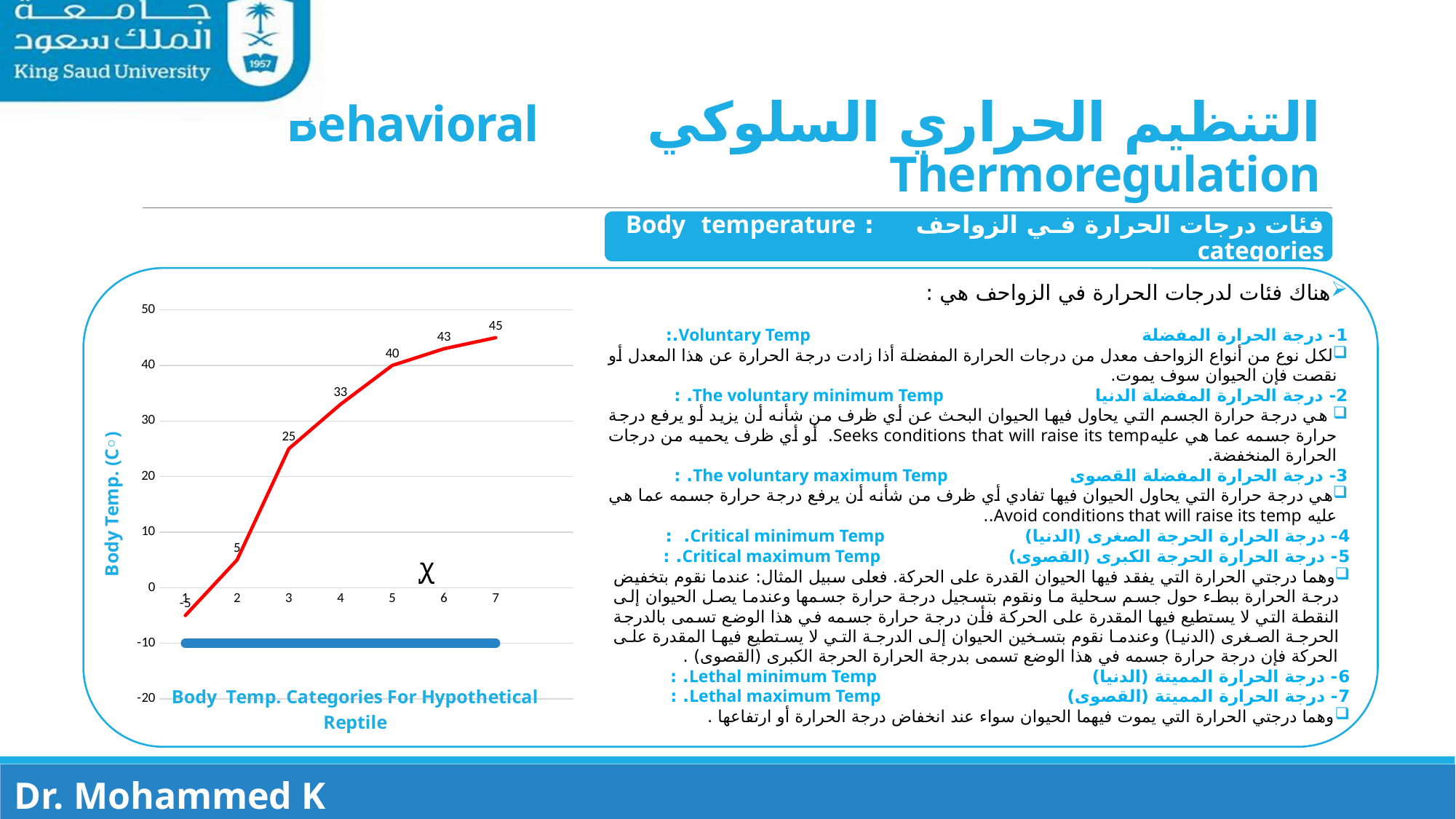
What is the difference between the values at category 3 and category 2? 20 What is the value at category 5 in the chart? 40 How many categories are shown on the x axis? 7 What is the difference between the values at category 7 and category 6? 2 What is the value at category 3 in the chart? 25 Do the values on the red line rise or fall from category 1 to category 7? rise What is the value at category 1 in the chart? -5 What kind of chart is shown on the slide? line chart Which category has the highest value on the red line? 7 Is the value at category 6 greater or less than 40? greater Which is larger, the value at category 4 or the value at category 2? category 4 Which category has the lowest value on the red line? 1